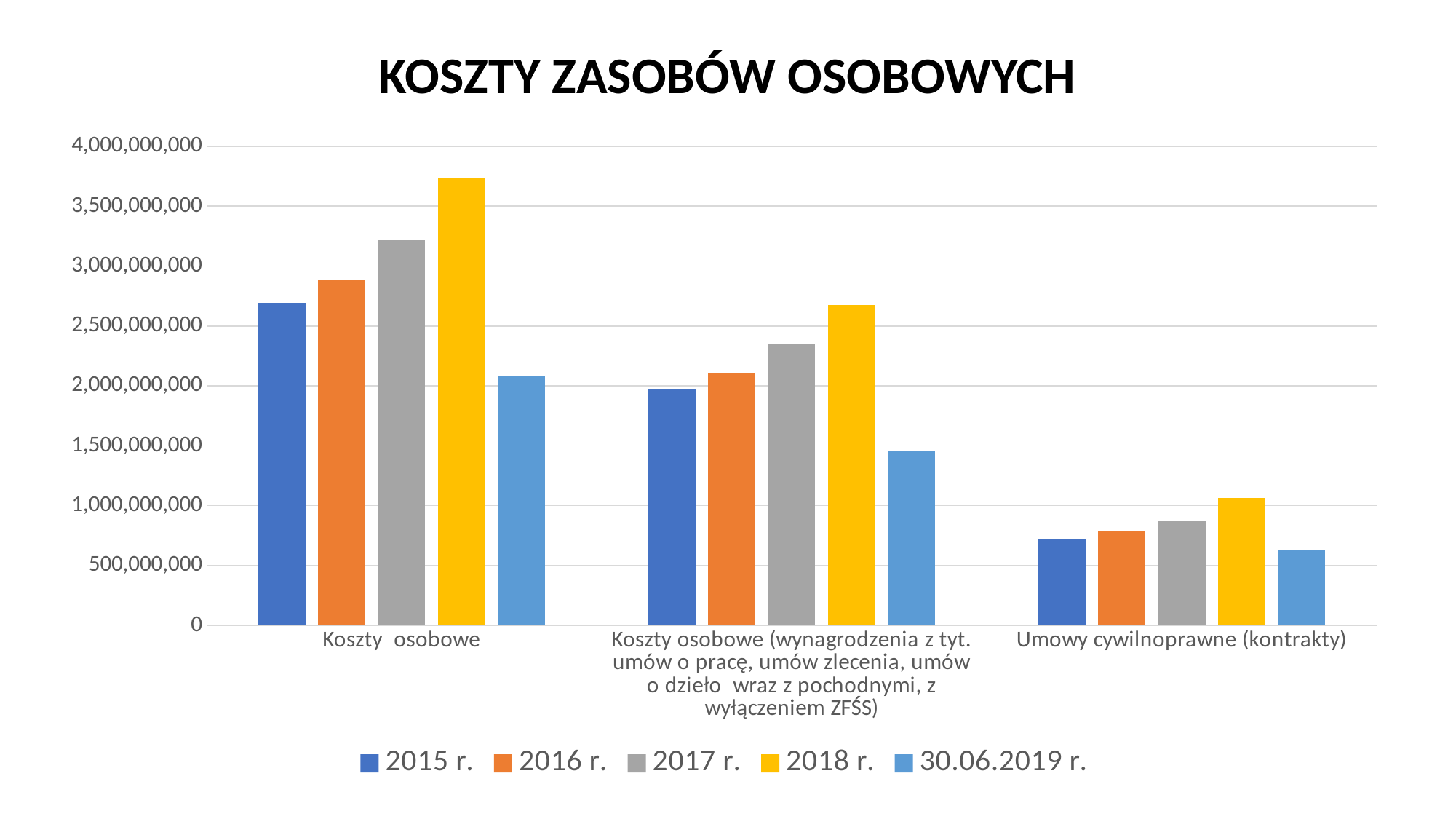
Is the 2017 r. value for 'Koszty osobowe (wynagrodzenia z tyt. umów o pracę, umów zlecenia, umów o dzieło wraz z pochodnymi, z wyłączeniem ZFŚS)' greater or less than 2,000,000,000? greater Is the 2017 r. value for 'Umowy cywilnoprawne (kontrakty)' greater or less than 1,000,000,000? less Which series has the lowest value in the 'Umowy cywilnoprawne (kontrakty)' category? 30.06.2019 r. Which series has the highest value in the 'Koszty osobowe' category? 2018 r. What is the last entry in the chart legend? 30.06.2019 r. How many series does the legend list? 5 Do the values for 'Umowy cywilnoprawne (kontrakty)' rise or fall from 2015 r. to 2018 r.? rise Is the 2018 r. value for 'Koszty osobowe' greater or less than 3,500,000,000? greater What type of chart is shown on the slide? bar chart What is the title of the chart? KOSZTY ZASOBÓW OSOBOWYCH How many categories are shown on the x axis? 3 In the 'Koszty osobowe' category, which is larger: the 2017 r. value or the 2016 r. value? 2017 r.